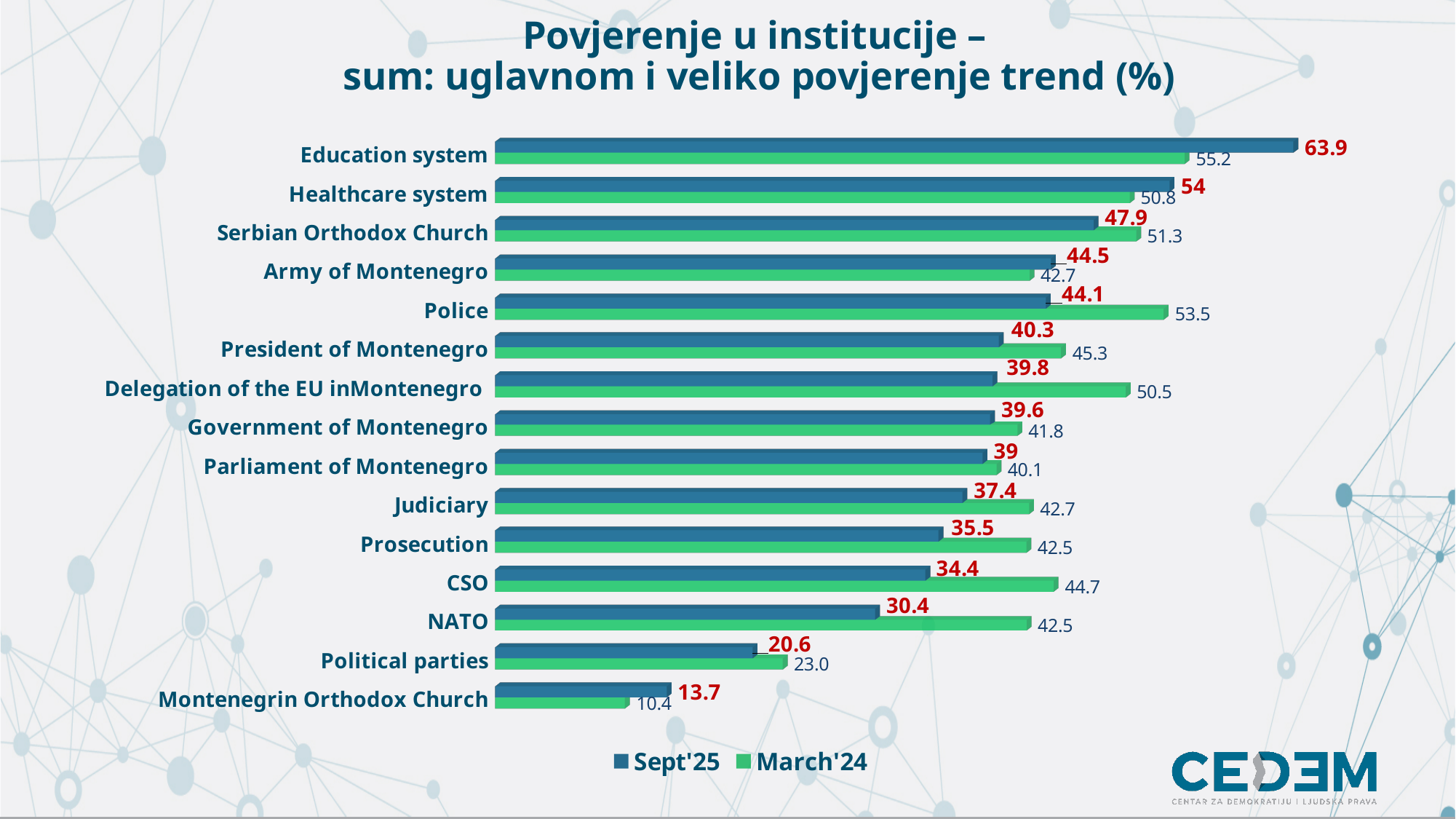
How many institutions are shown on the chart? 15 Which is larger for Serbian Orthodox Church: the Sept'25 value or the March'24 value? March'24 Which institution has the highest Sept'25 value? Education system What kind of chart is shown on the slide? Bar chart What is the difference between the Sept'25 and March'24 values for NATO? 12.1 How many series does the legend list? 2 Which series is shown in green in the legend? March'24 What is the difference between the Sept'25 and March'24 values for Education system? 8.7 What is the March'24 value for Police? 53.5 Which institution has the lowest March'24 value? Montenegrin Orthodox Church What is the Sept'25 value for Education system? 63.9 What is the March'24 value for Montenegrin Orthodox Church? 10.4